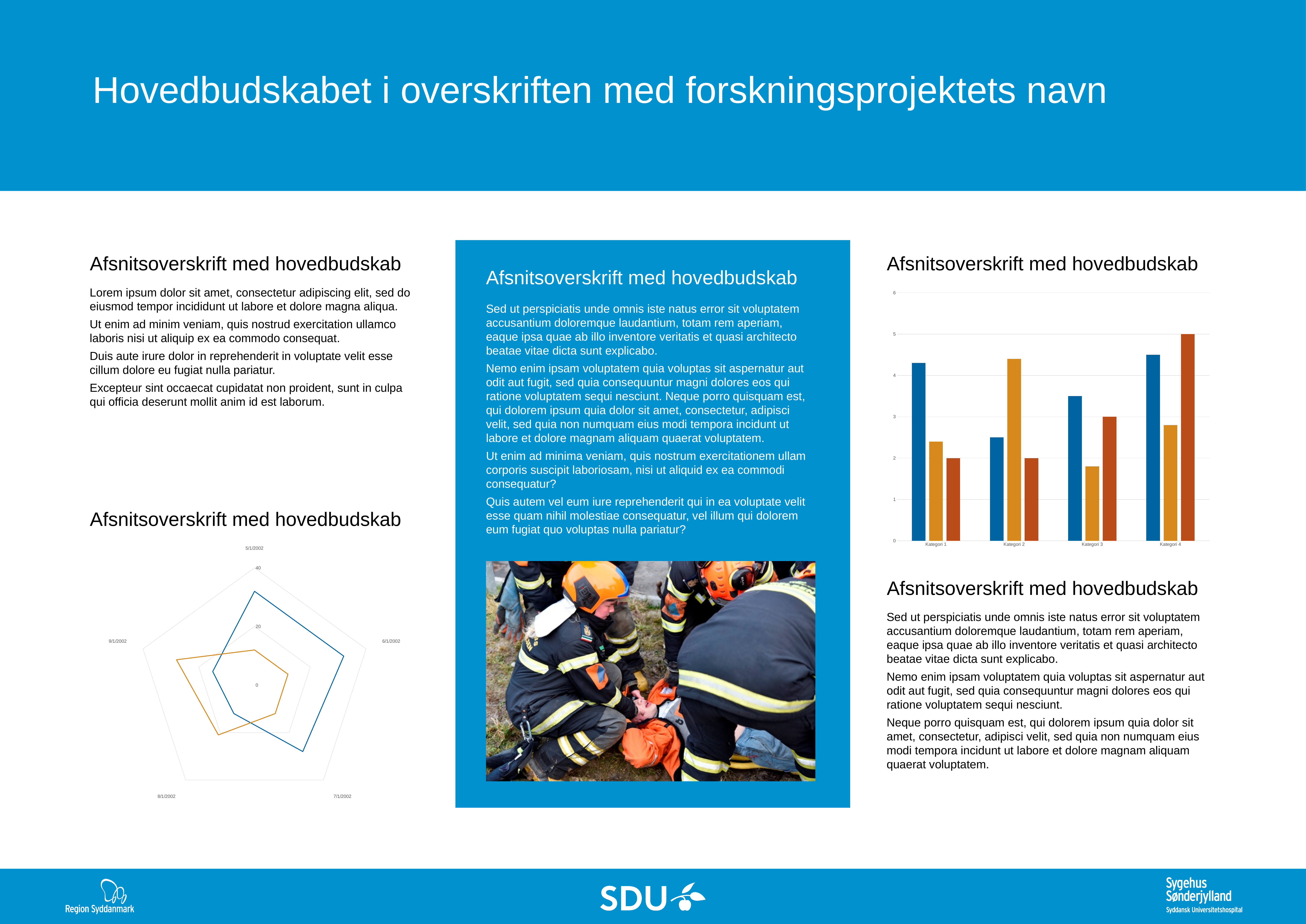
What kind of chart is the chart on the right side of the slide? bar chart In the bar chart on the right, is the value of the dark red bar for Kategori 4 greater or less than 4? greater In the radar chart at the bottom left, is the blue series value for 5/1/2002 greater or less than 20? greater What kind of chart is the chart at the bottom left of the slide? radar chart How many axes (categories) does the radar chart at the bottom left have? 5 In the bar chart on the right, which category contains the tallest bar? Kategori 4 How many bars are plotted for each category in the bar chart on the right? 3 How many categories are shown on the x axis of the bar chart on the right? 4 In the bar chart on the right, is the value of the orange bar for Kategori 3 greater or less than 2? less What is the highest value labelled on the scale of the radar chart at the bottom left? 40 In the bar chart on the right, for Kategori 2, which is larger: the blue bar or the orange bar? the orange bar